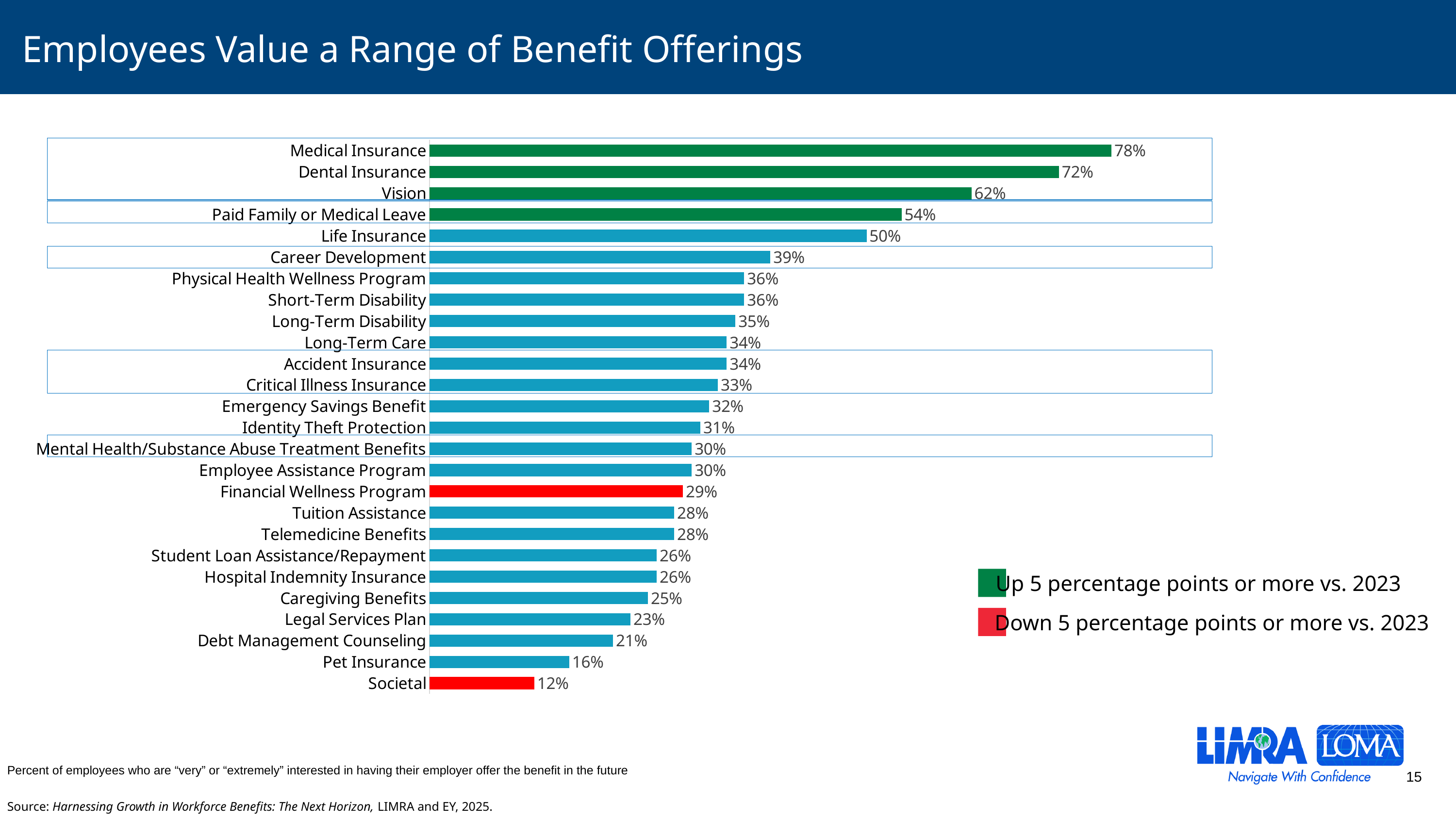
What is the value shown for Career Development? 39% Which has a larger value, Vision or Paid Family or Medical Leave? Vision Which benefit has the lowest value on the chart? Societal Which benefit has the highest value on the chart? Medical Insurance What percentage of employees are interested in Medical Insurance? 78% What type of chart is shown on the slide? Bar chart How many benefit categories are shown on the chart? 26 What is the difference between the values for Medical Insurance and Dental Insurance? 6% What is the difference between the values for Life Insurance and Societal? 38% What is the value shown for Pet Insurance? 16% Which benefits are shown with red bars, indicating a drop of 5 percentage points or more vs. 2023? Financial Wellness Program and Societal What is the value shown for Financial Wellness Program? 29%